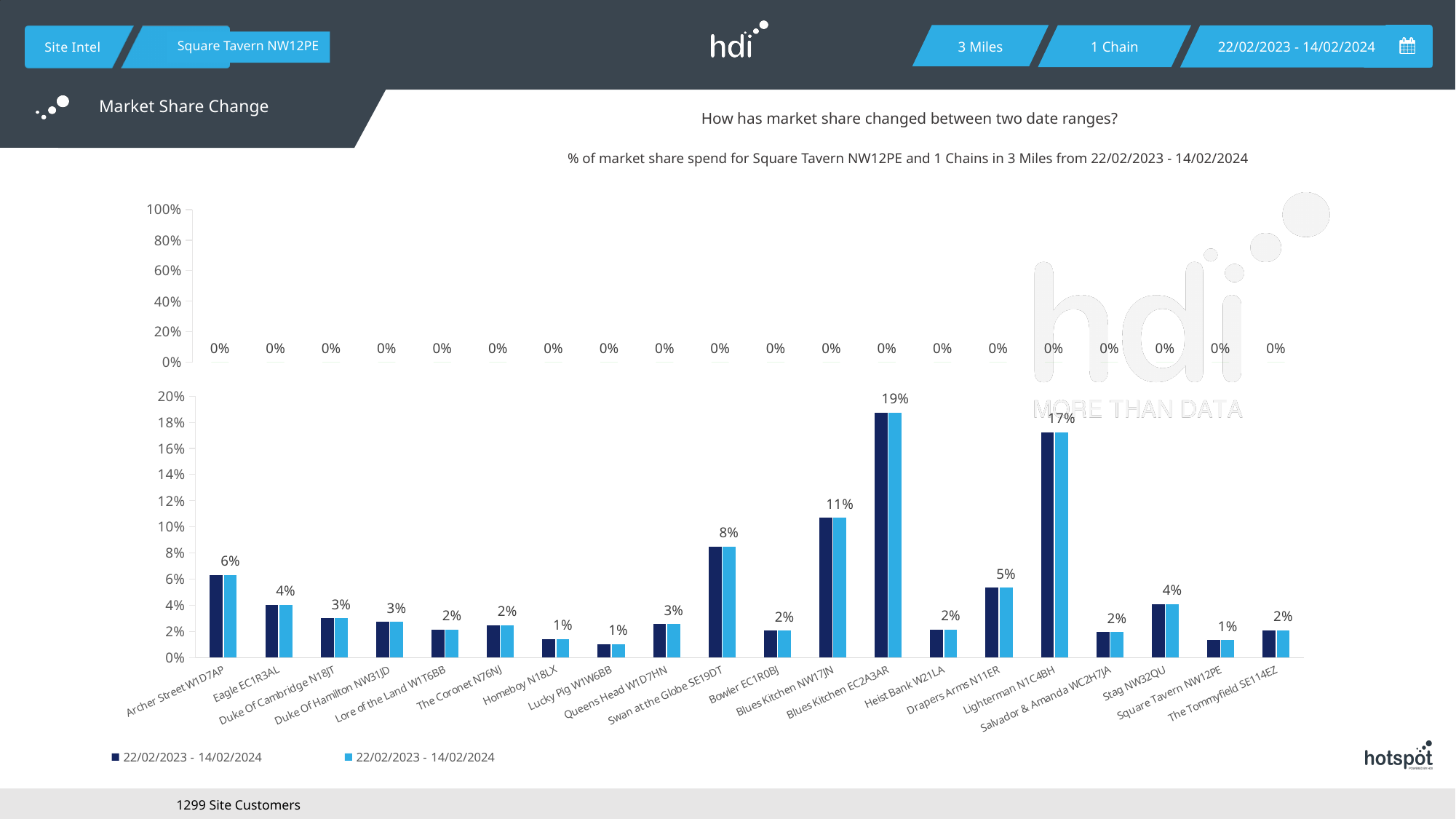
What kind of chart is the lower chart? bar chart In the lower chart, what value is labelled for Lighterman N1C4BH? 17% How many categories are shown on the x axis of the lower chart? 20 In the lower chart, what value is labelled for Square Tavern NW12PE? 1% How many series does the legend list? 2 In the upper chart, what value is labelled for Archer Street W1D7AP? 0% In the lower chart, what is the difference between the labelled values for Blues Kitchen EC2A3AR and Lighterman N1C4BH? 2% In the lower chart, what value is labelled for Swan at the Globe SE19DT? 8% In the lower chart, is the value for Blues Kitchen NW17JN greater or less than 10%? greater In the lower chart, which is larger: the value for Swan at the Globe SE19DT or the value for Drapers Arms N11ER? Swan at the Globe SE19DT In the lower chart, which category has the highest value? Blues Kitchen EC2A3AR In the lower chart, what value is labelled for Blues Kitchen EC2A3AR? 19%